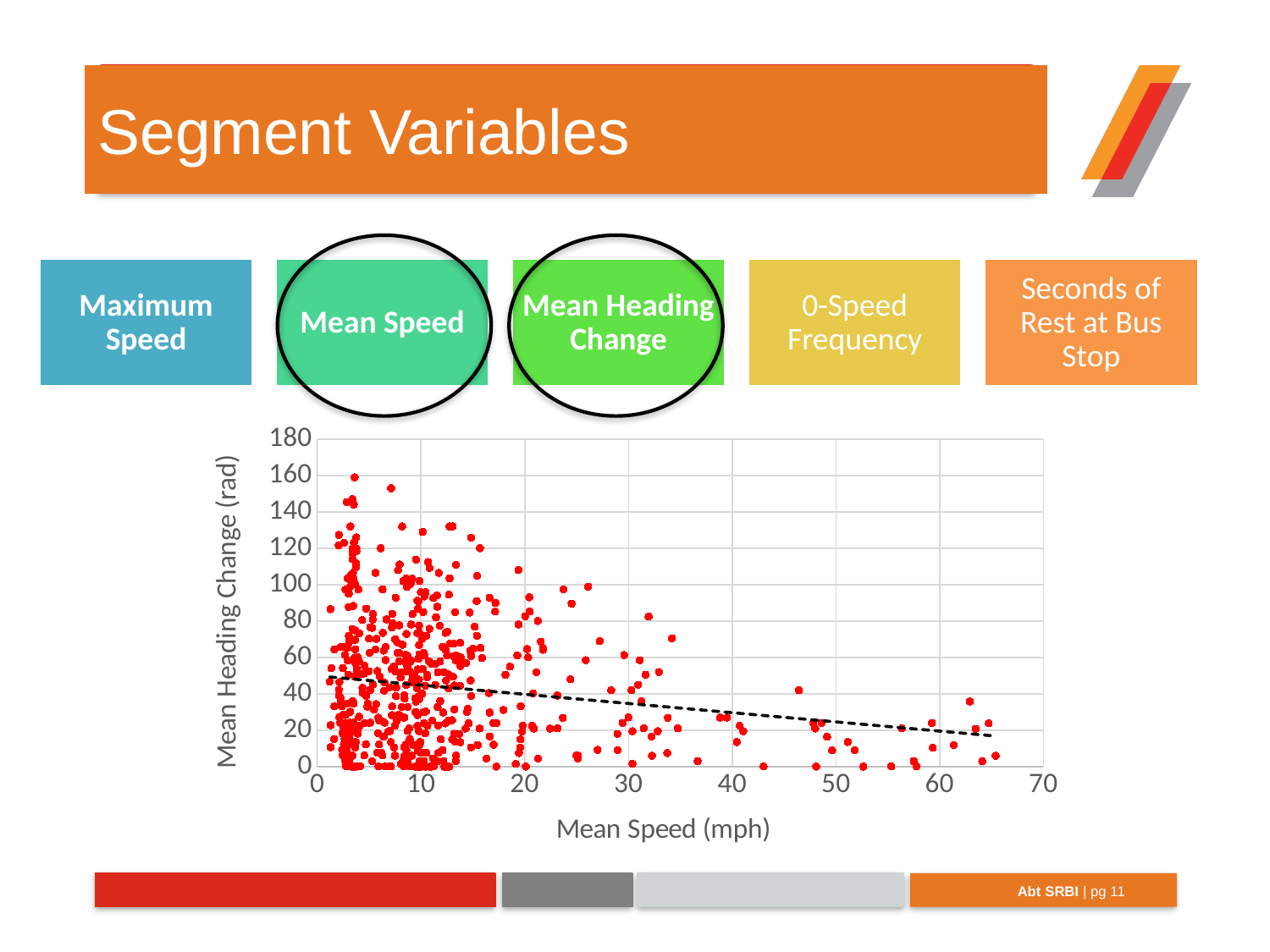
Is the highest plotted Mean Heading Change value greater or less than 140? greater What is the maximum value shown on the y axis? 180 Is the highest plotted Mean Speed value greater or less than 60? greater Is the value of the trend line at a Mean Speed of 0 mph greater or less than 40? greater What is the maximum value shown on the x axis? 70 What is the title of the y axis of the chart? Mean Heading Change (rad) Does the dashed trend line rise or fall as Mean Speed increases? fall What kind of chart is shown on the slide? scatter chart